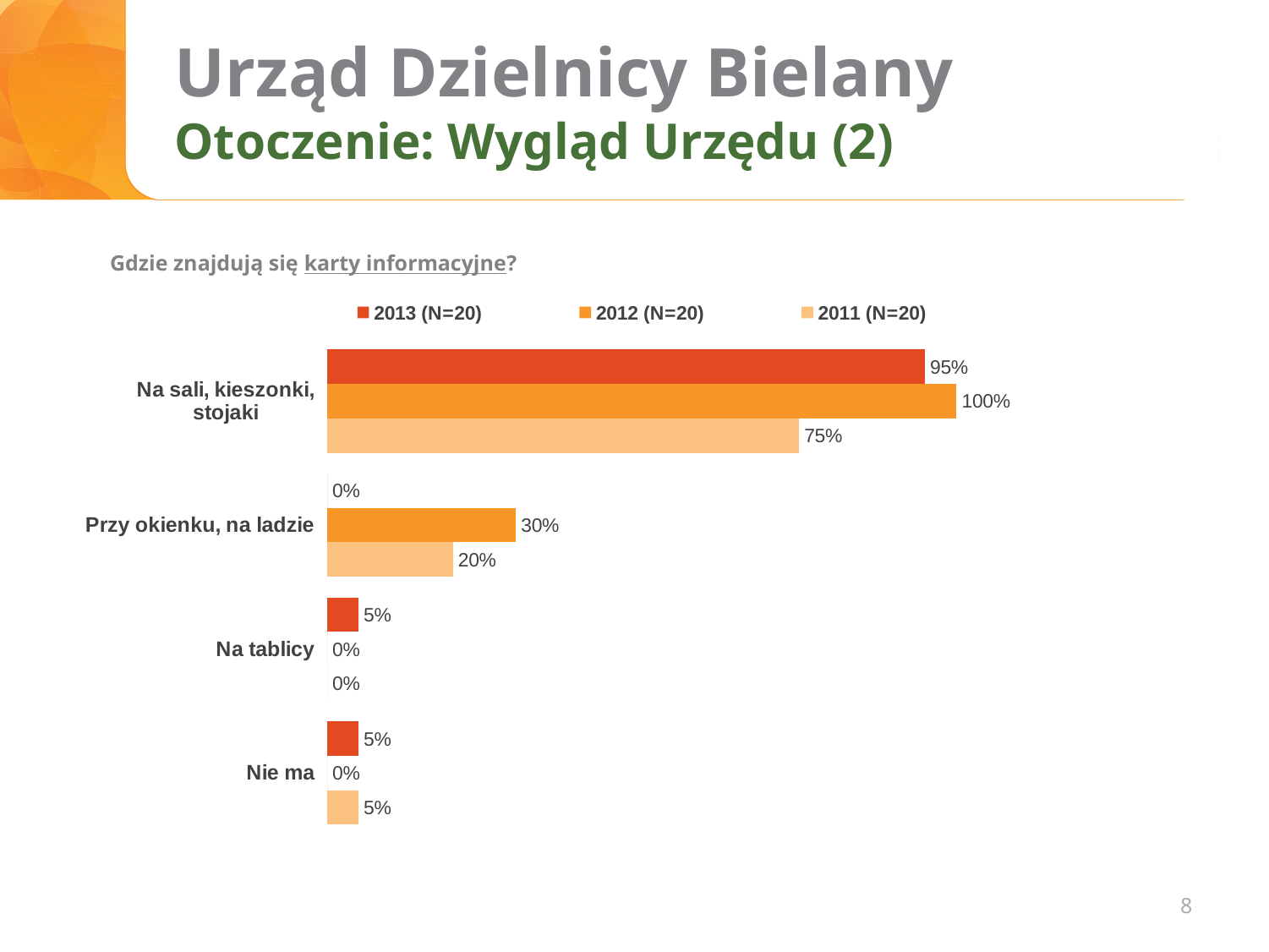
Which category has the highest value in the 2011 (N=20) series? Na sali, kieszonki, stojaki Which is larger for 'Przy okienku, na ladzie': the 2012 (N=20) value or the 2011 (N=20) value? 2012 (N=20) What is the value for 'Nie ma' in the 2011 (N=20) series? 5% What is the value for 'Przy okienku, na ladzie' in the 2013 (N=20) series? 0% How many series does the legend list? 3 How many categories are shown on the chart? 4 What question does the chart answer, according to the text above it? Gdzie znajdują się karty informacyjne? What is the difference between the 2012 (N=20) and 2011 (N=20) values for 'Na sali, kieszonki, stojaki'? 25% What is the value for 'Na sali, kieszonki, stojaki' in the 2013 (N=20) series? 95% What is the value for 'Na tablicy' in the 2013 (N=20) series? 5% What is the value for 'Przy okienku, na ladzie' in the 2012 (N=20) series? 30% What kind of chart is shown on the slide? Bar chart